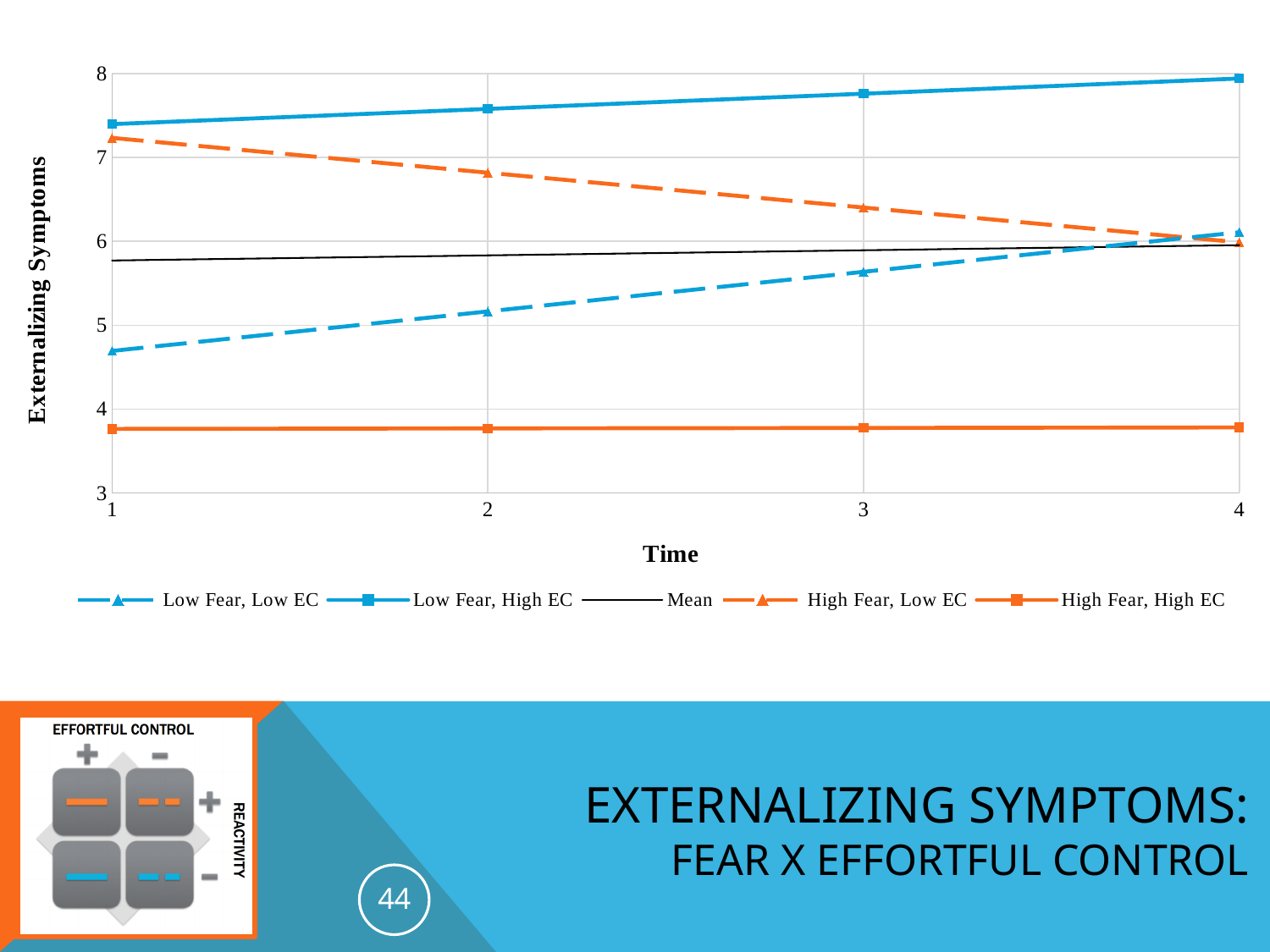
Does the High Fear, Low EC line rise or fall from Time 1 to Time 4? fall Is the value for Low Fear, High EC at Time 1 greater or less than 7? greater Does the Low Fear, Low EC line rise or fall from Time 1 to Time 4? rise How many time points are plotted along the x axis? 4 Which series has the lowest Externalizing Symptoms value at Time 4? High Fear, High EC Which series has the highest Externalizing Symptoms value at Time 4? Low Fear, High EC How many series does the legend list? 5 What kind of chart is shown on the slide? line chart Is the value for Low Fear, Low EC at Time 1 greater or less than 5? less Is the value for High Fear, High EC at Time 2 greater or less than 4? less What is the label of the y axis? Externalizing Symptoms At Time 2, which is larger: Low Fear, High EC or High Fear, Low EC? Low Fear, High EC